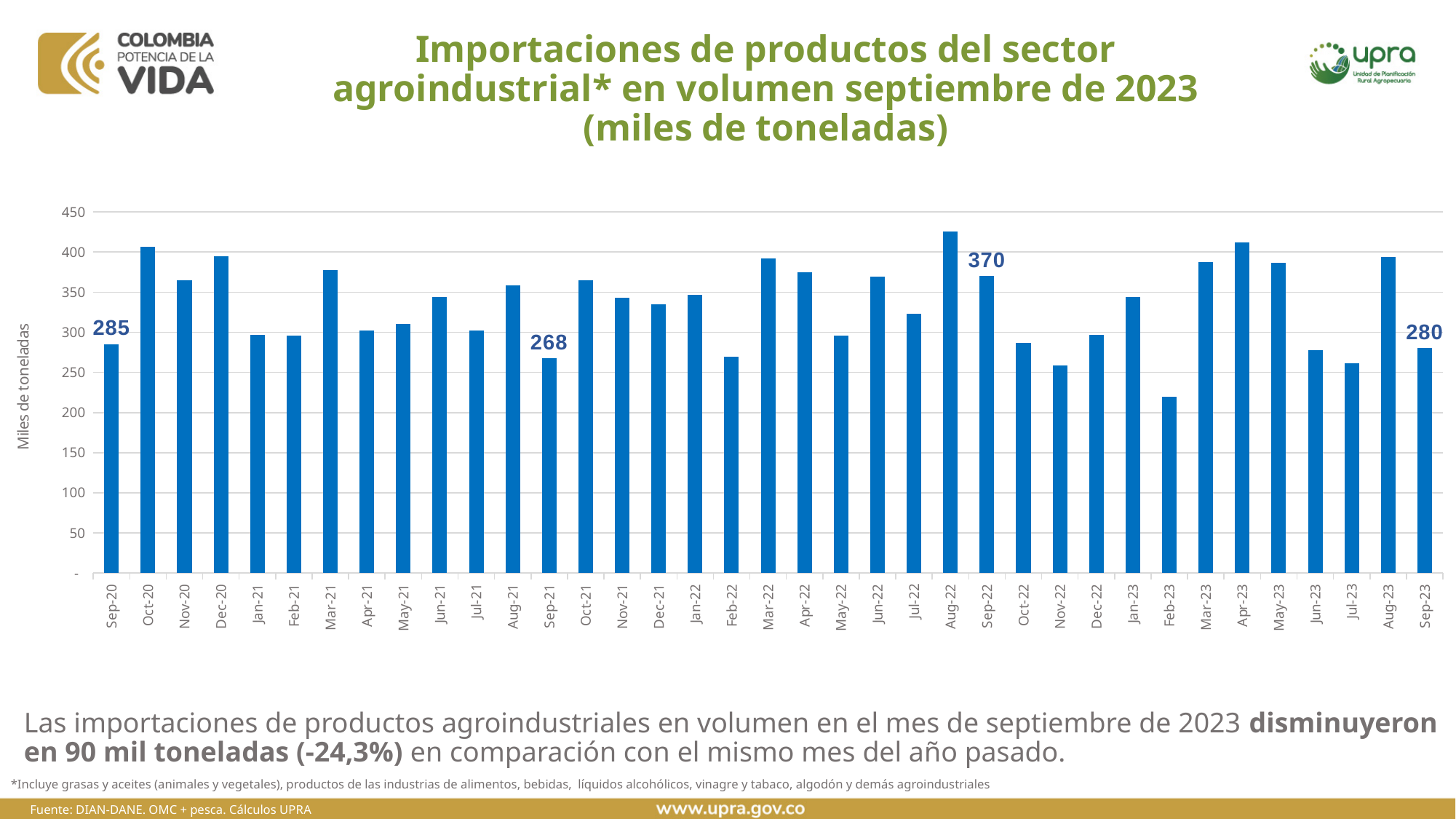
What kind of chart is shown on the slide? Bar chart Is the value for Aug-22 greater or less than 400? greater Which month has the highest bar? Aug-22 How many months (bars) are shown on the chart? 37 What is the value for Sep-23? 280 What is the value for Sep-20? 285 What is the value for Sep-22? 370 What is the difference between the values for Sep-22 and Sep-23? 90 What is the value for Sep-21? 268 Which is larger, the value for Sep-20 or the value for Sep-21? Sep-20 Is the value for Feb-23 greater or less than 250? less Which month has the lowest bar? Feb-23